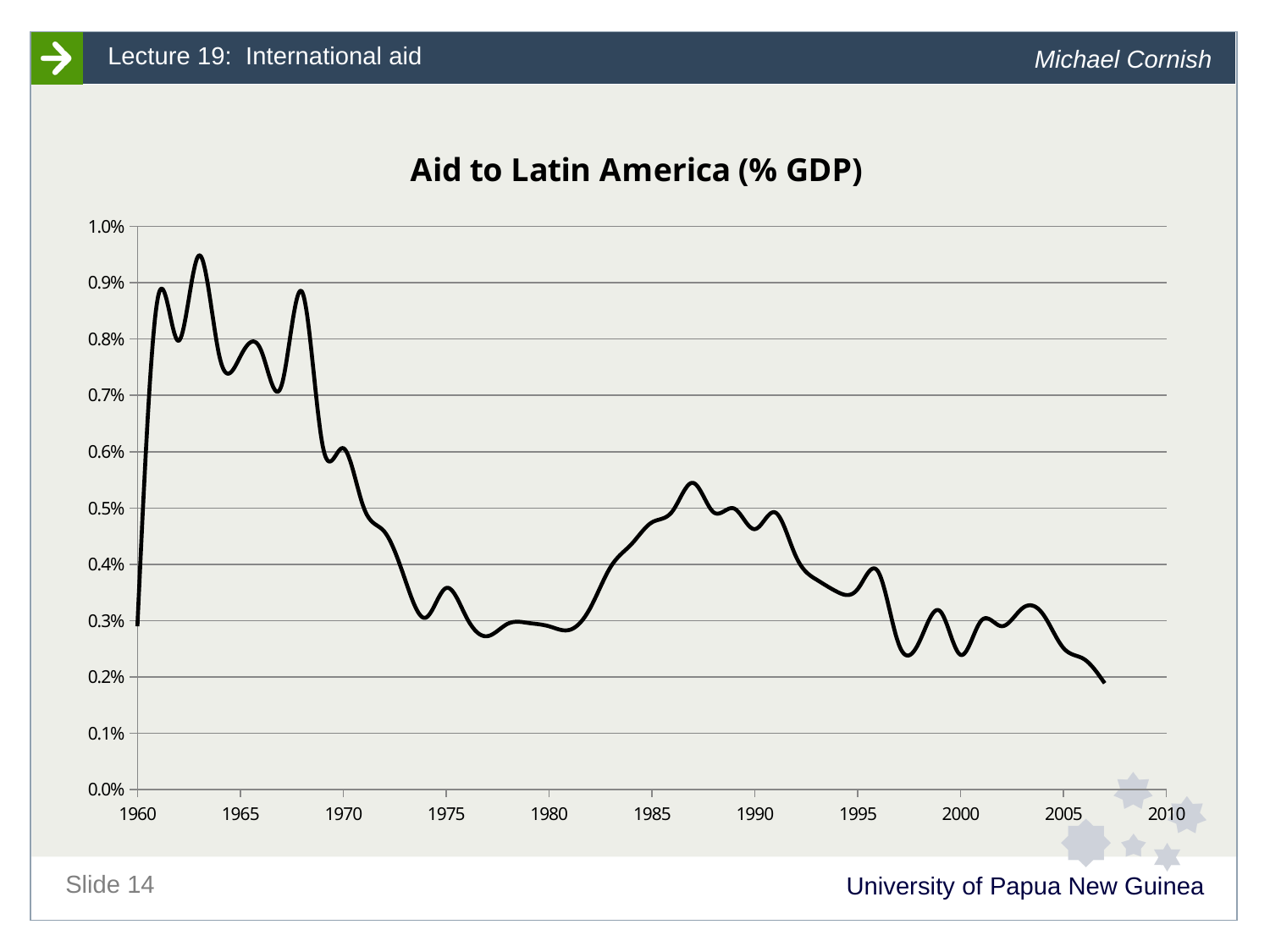
In which year does the line reach its highest value? 1963 Which is larger, the value in 1975 or the value in 1987? 1987 What is the title of the chart? Aid to Latin America (% GDP) Is the value for 1963 greater or less than 0.9%? greater What kind of chart is shown on the slide? line chart Which is larger, the value in 1965 or the value in 1985? 1965 Is the value for 1970 greater or less than 0.5%? greater Is the value for 1980 greater or less than 0.4%? less Overall, does aid to Latin America as a share of GDP rise or fall between 1960 and 2010? fall What is the highest value shown on the vertical axis? 1.0%